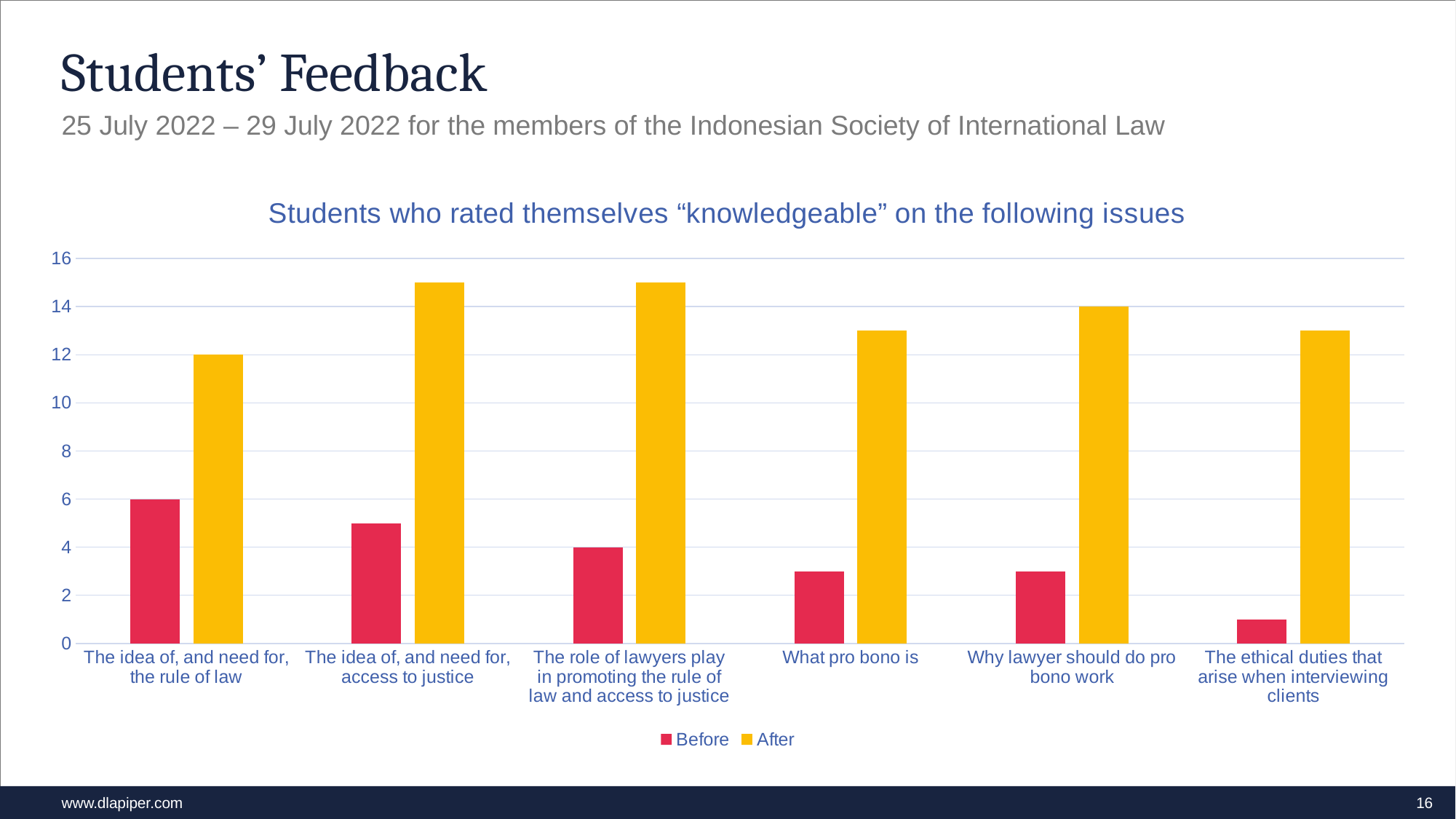
What kind of chart is shown on the slide? bar chart What is the Before value for "The role of lawyers play in promoting the rule of law and access to justice"? 4 How many series does the legend list? 2 Which category has the lowest Before value? The ethical duties that arise when interviewing clients Which category has the highest Before value? The idea of, and need for, the rule of law What is the Before value for "The idea of, and need for, the rule of law"? 6 Is the After value for "What pro bono is" greater or less than 12? greater What is the After value for "The idea of, and need for, the rule of law"? 12 What is the After value for "Why lawyer should do pro bono work"? 14 How many issue categories are shown on the x axis? 6 Is the Before value for "The ethical duties that arise when interviewing clients" greater or less than 2? less For "What pro bono is", which is larger, the Before value or the After value? After